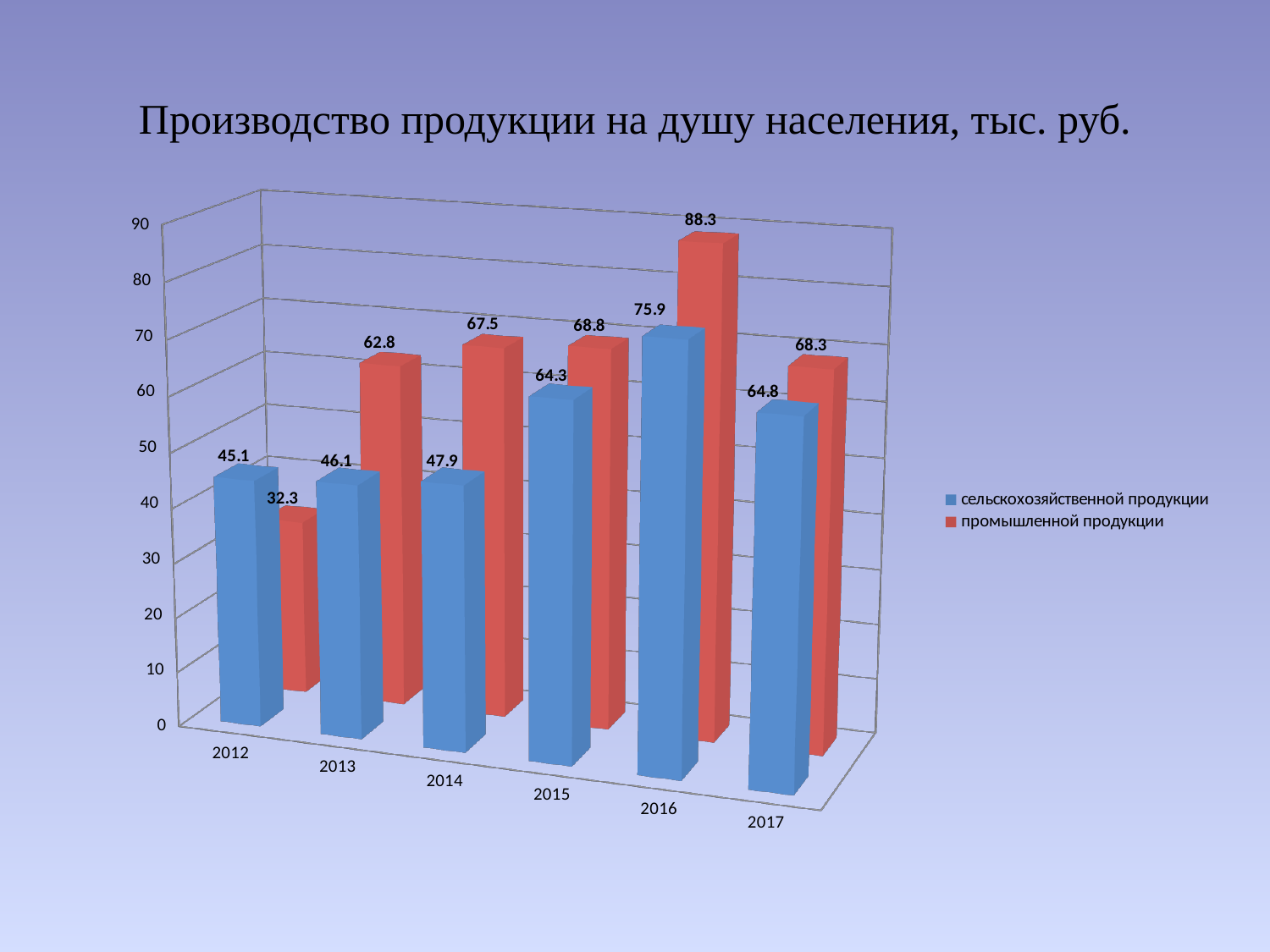
In which year is the value for сельскохозяйственной продукции highest? 2016 Which is larger in 2012: сельскохозяйственной продукции or промышленной продукции? сельскохозяйственной продукции What kind of chart is shown on the slide? bar chart Does the value for сельскохозяйственной продукции rise or fall from 2012 to 2016? rise What is the difference between промышленной продукции and сельскохозяйственной продукции in 2013? 16.7 What is the value for промышленной продукции in 2016? 88.3 What is the value for промышленной продукции in 2012? 32.3 What is the title of the chart? Производство продукции на душу населения, тыс. руб. What is the value for сельскохозяйственной продукции in 2012? 45.1 How many years are shown on the x axis? 6 How many series does the legend list? 2 In which year is the value for промышленной продукции lowest? 2012